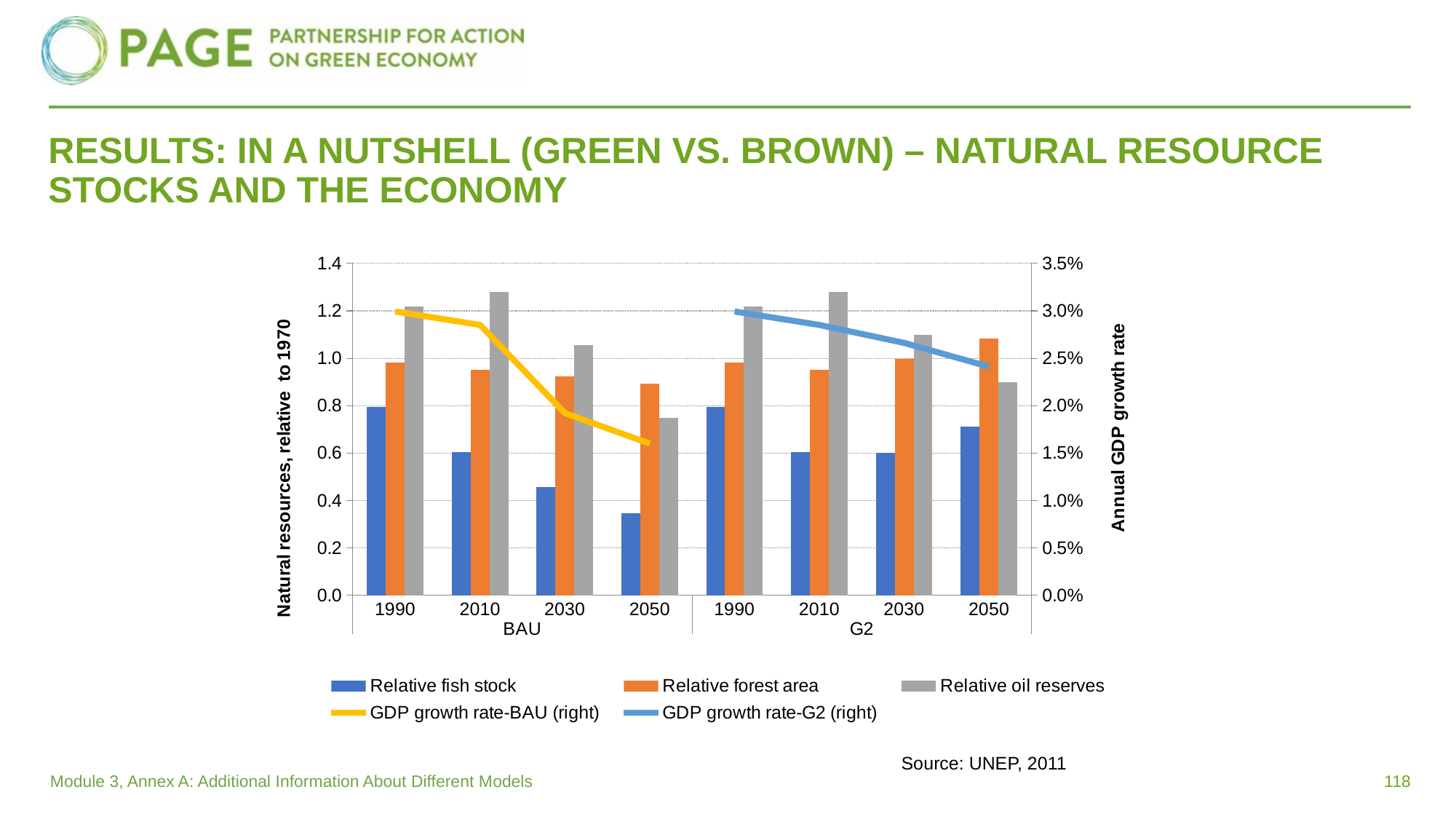
Is the GDP growth rate-BAU in 2050 greater or less than 2.0%? less Is the value for relative forest area in 2050 under G2 greater or less than 1.0? greater Is the value for relative fish stock in 2050 under BAU greater or less than 0.4? less What kind of chart is used to plot the relative fish stock, forest area and oil reserves series? Bar chart How many year categories are shown along the x axis in total across the BAU and G2 scenarios? 8 Which scenario has the higher GDP growth rate in 2050, BAU or G2? G2 What is the title of the right-hand vertical axis? Annual GDP growth rate Does the relative fish stock rise or fall from 1990 to 2050 under the BAU scenario? fall Within the BAU scenario, which year has the lowest relative fish stock? 2050 Which is larger in 2050: the relative fish stock under BAU or under G2? G2 How many series does the legend list? 5